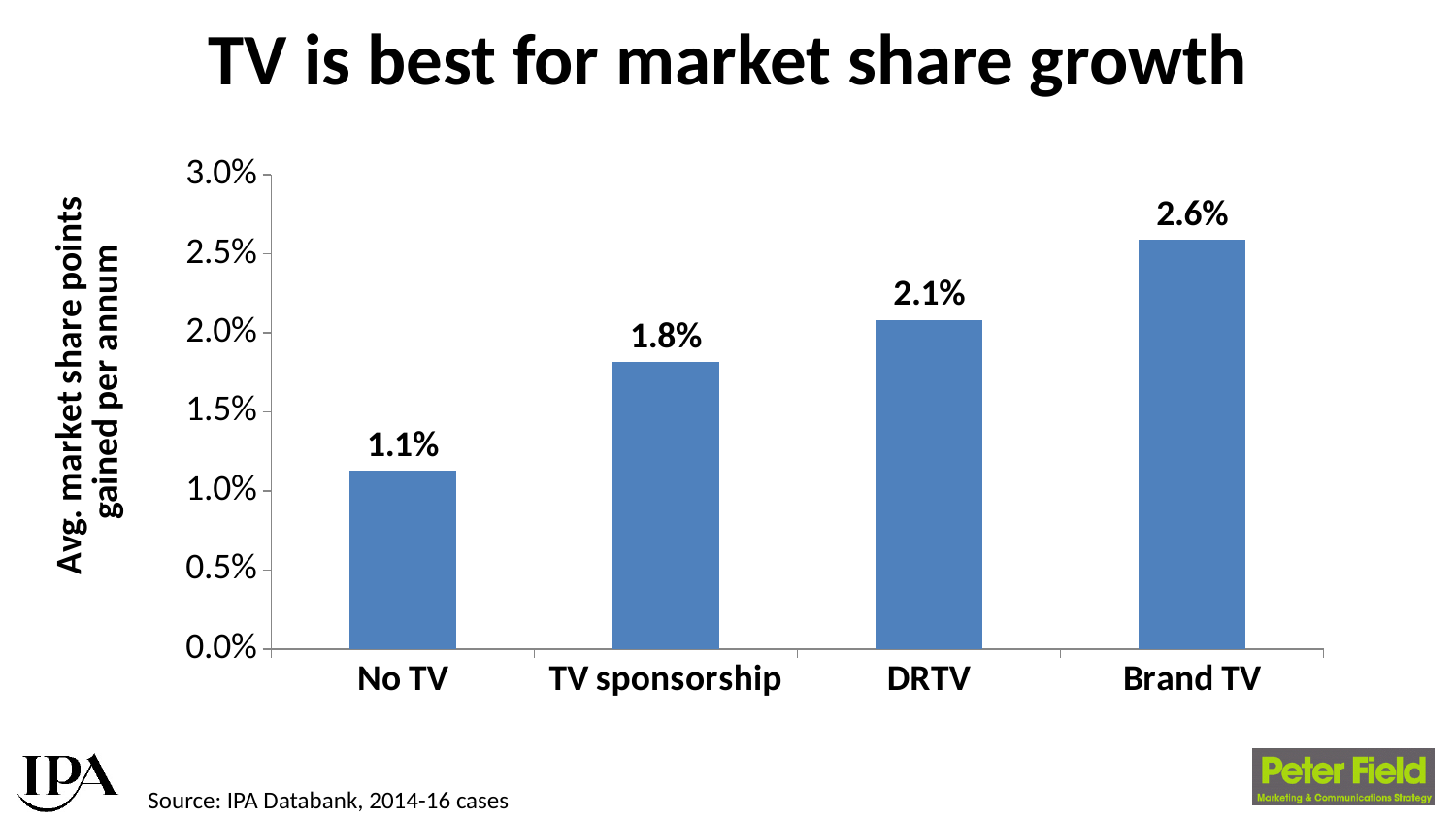
Is the value for DRTV greater or less than 2.0%? greater What is the value shown for Brand TV? 2.6% What is the value shown for TV sponsorship? 1.8% How many categories are shown on the x axis? 4 What is the value shown for DRTV? 2.1% Which category has the lowest average market share points gained per annum? No TV What is the average market share points gained per annum for No TV? 1.1% Which category has the highest average market share points gained per annum? Brand TV Which is larger, the value for DRTV or the value for TV sponsorship? DRTV What kind of chart is shown on the slide? Bar chart Do the values rise or fall from left to right along the x axis? Rise What is the difference between the values for Brand TV and No TV? 1.5%